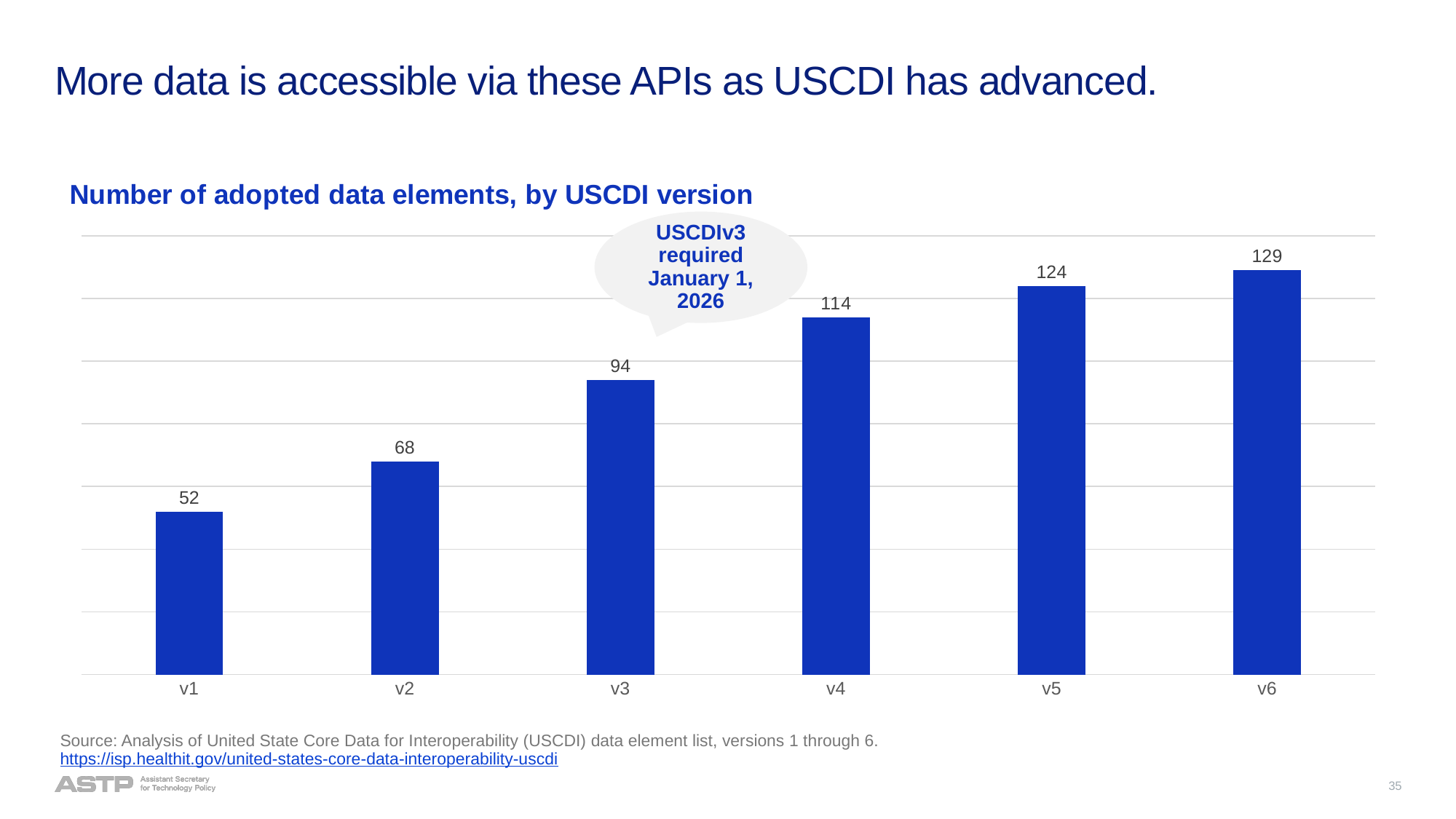
Which USCDI version has the highest number of adopted data elements? v6 How many USCDI versions are shown on the chart? 6 What is the number of adopted data elements for USCDI v1? 52 What kind of chart is shown on the slide? Bar chart What is the number of adopted data elements for USCDI v5? 124 What is the title of the chart? Number of adopted data elements, by USCDI version Do the values rise or fall from v1 to v6? Rise Which USCDI version has the lowest number of adopted data elements? v1 What is the difference in adopted data elements between v4 and v3? 20 Which has more adopted data elements, v2 or v4? v4 What is the difference in adopted data elements between v6 and v1? 77 What is the number of adopted data elements for USCDI v3? 94